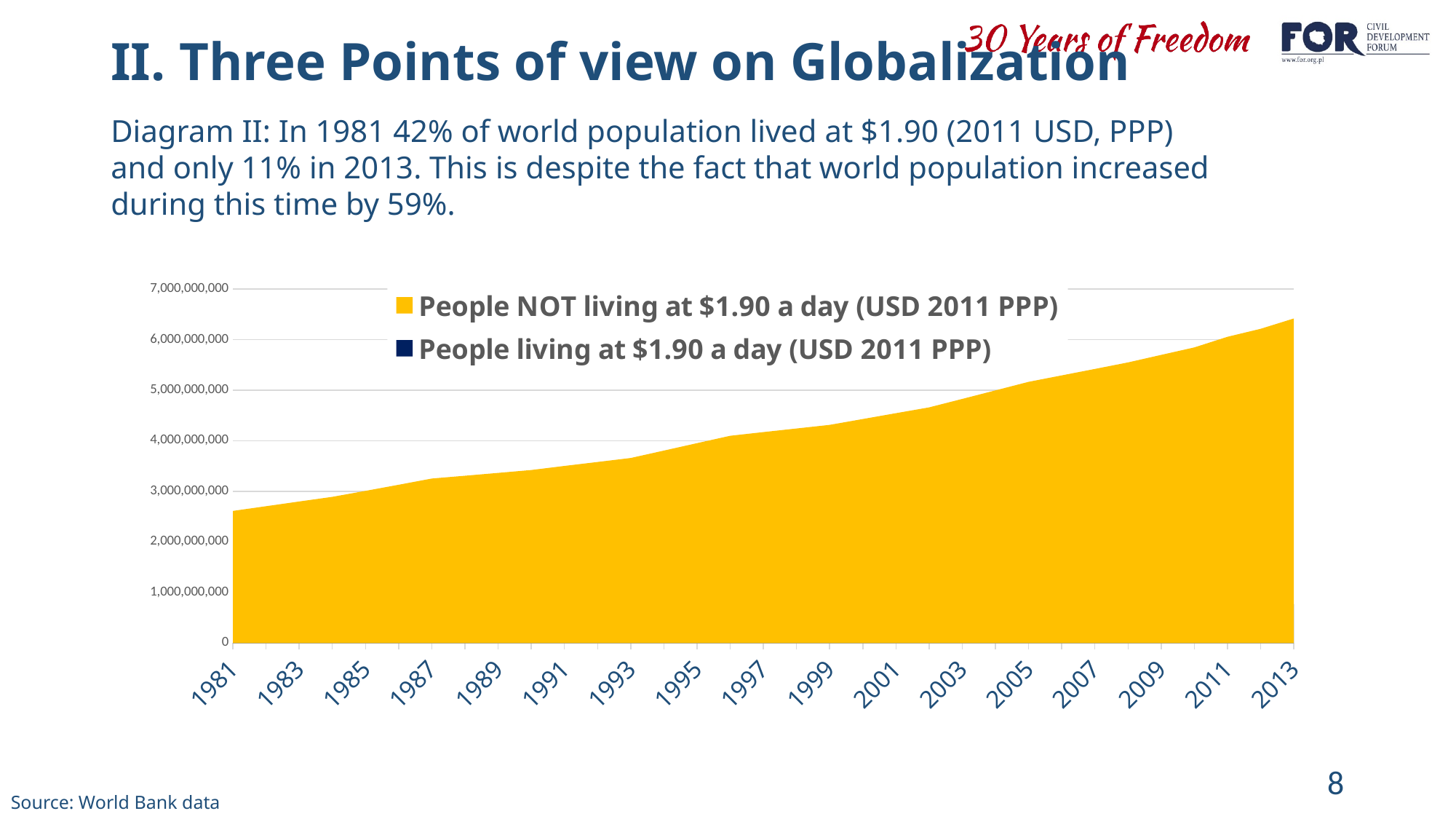
What kind of chart is shown on the slide? Area chart How many year labels are shown on the x axis? 17 Is the value for People NOT living at $1.90 a day in 2013 greater or less than 6,000,000,000? greater Which year has the larger value for People NOT living at $1.90 a day, 1985 or 2005? 2005 In which year is the value for People NOT living at $1.90 a day lowest? 1981 Is the value for People NOT living at $1.90 a day in 1981 greater or less than 3,000,000,000? less In which year is the value for People NOT living at $1.90 a day highest? 2013 How many series does the chart's legend list? 2 Is the value for People NOT living at $1.90 a day in 2001 greater or less than 4,000,000,000? greater What colour is used for the series People NOT living at $1.90 a day (USD 2011 PPP)? Yellow Does the plotted area for People NOT living at $1.90 a day rise or fall from 1981 to 2013? Rises